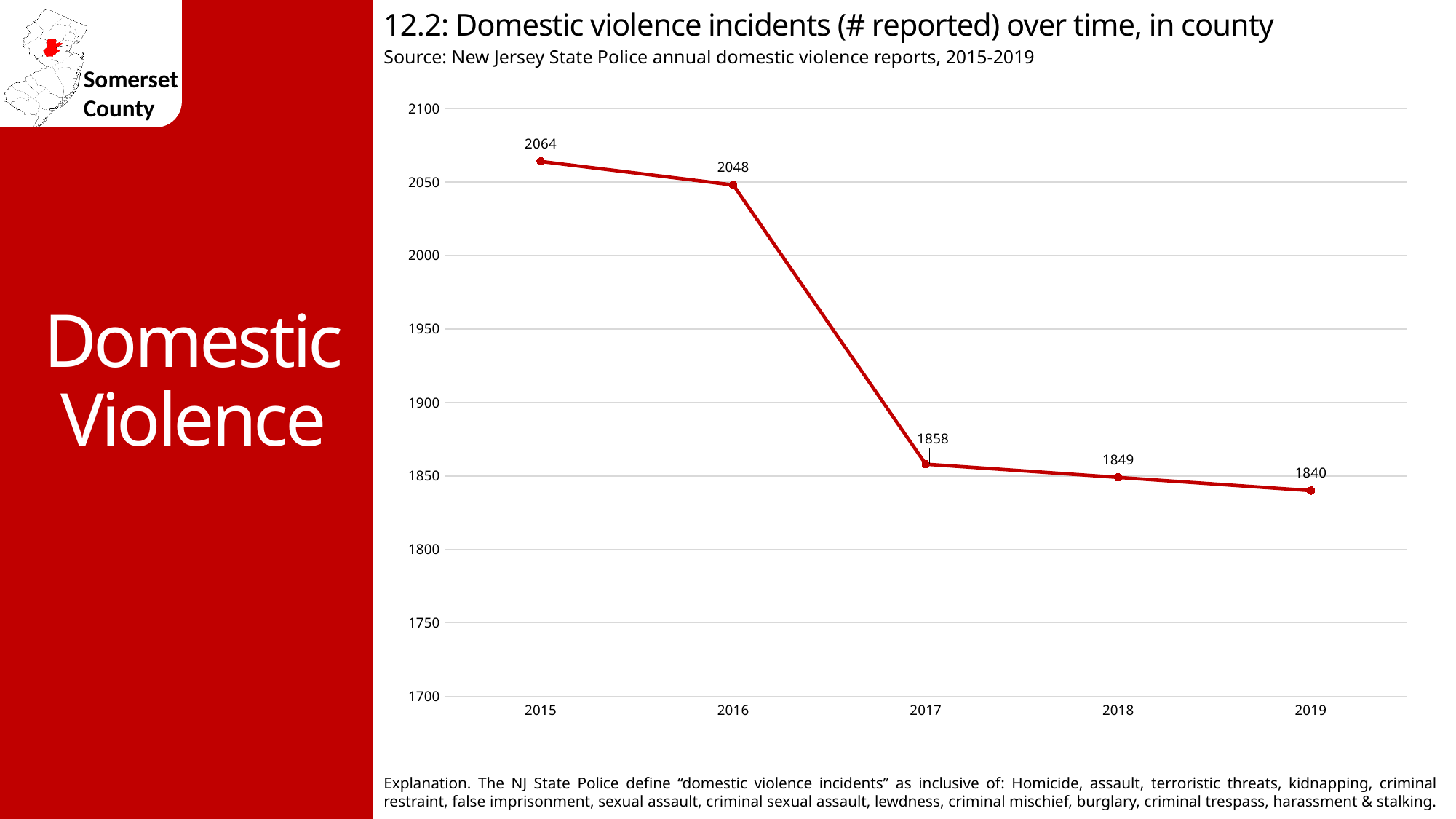
Is the value for 2016 greater or less than 2000? greater How many years are plotted on the chart? 5 What is the number of reported domestic violence incidents for 2017? 1858 What value is shown for 2019? 1840 Which year had more reported incidents, 2018 or 2019? 2018 By how much did reported incidents decrease from 2015 to 2019? 224 How many domestic violence incidents were reported in 2015? 2064 What is the difference between the number of incidents in 2016 and 2017? 190 Which year has the lowest number of reported domestic violence incidents? 2019 Do the reported domestic violence incidents rise or fall from 2015 to 2019? Fall Which year has the highest number of reported domestic violence incidents? 2015 What kind of chart is shown on the slide? Line chart